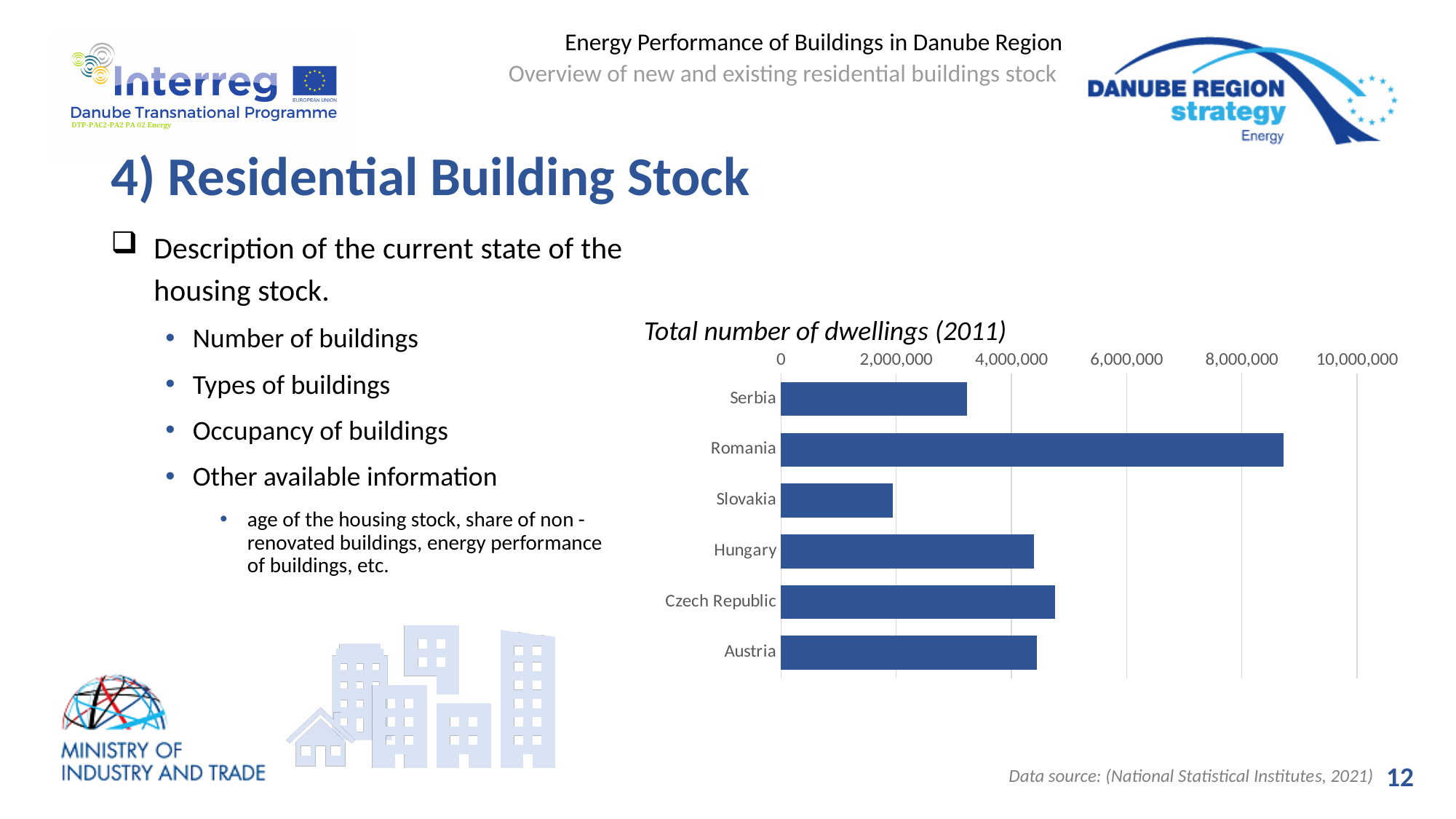
Which has more dwellings, Czech Republic or Serbia? Czech Republic Which country has the highest total number of dwellings? Romania Is the value for Austria greater or less than 4,000,000? greater Which has more dwellings, Romania or Hungary? Romania How many countries are shown in the chart? 6 Is the value for Slovakia greater or less than 4,000,000? less Is the value for Serbia greater or less than 2,000,000? greater What is the title of the chart? Total number of dwellings (2011) Which country has the lowest total number of dwellings? Slovakia What type of chart is shown on the slide? bar chart